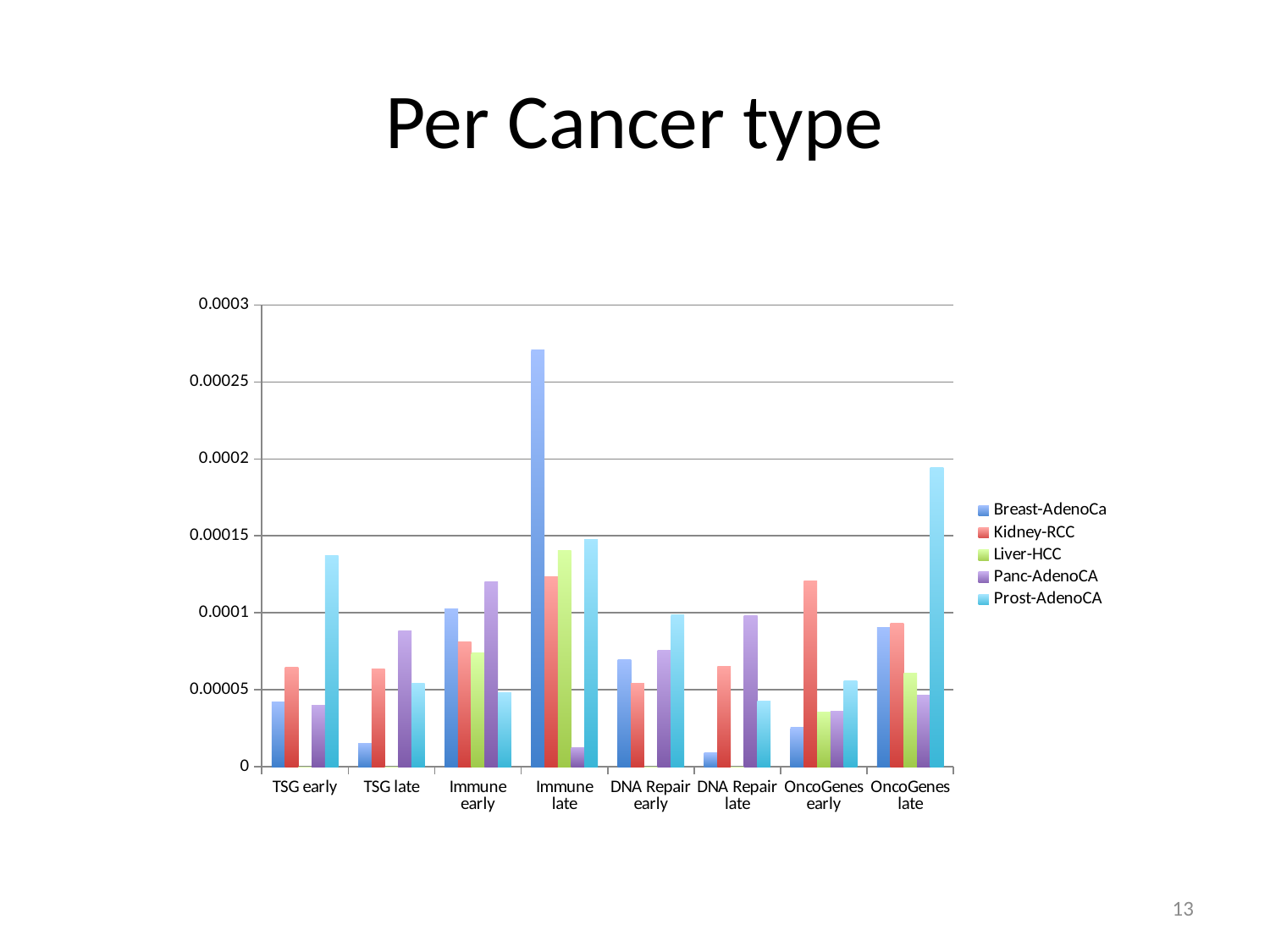
For which category is the Breast-AdenoCa value highest? Immune late For which category is the Prost-AdenoCA value highest? OncoGenes late How many categories are shown along the x axis? 8 What is the title of the chart? Per Cancer type For OncoGenes early, which is larger: Kidney-RCC or Breast-AdenoCa? Kidney-RCC Is the Breast-AdenoCa value for Immune late greater or less than 0.00025? greater What kind of chart is shown on the slide? bar chart Is the Prost-AdenoCA value for TSG early greater or less than 0.0001? greater For which category is the Breast-AdenoCa value lowest? DNA Repair late Is the Panc-AdenoCA value for Immune late greater or less than 0.00005? less How many series does the legend list? 5 For Immune late, which is larger: Breast-AdenoCa or Kidney-RCC? Breast-AdenoCa